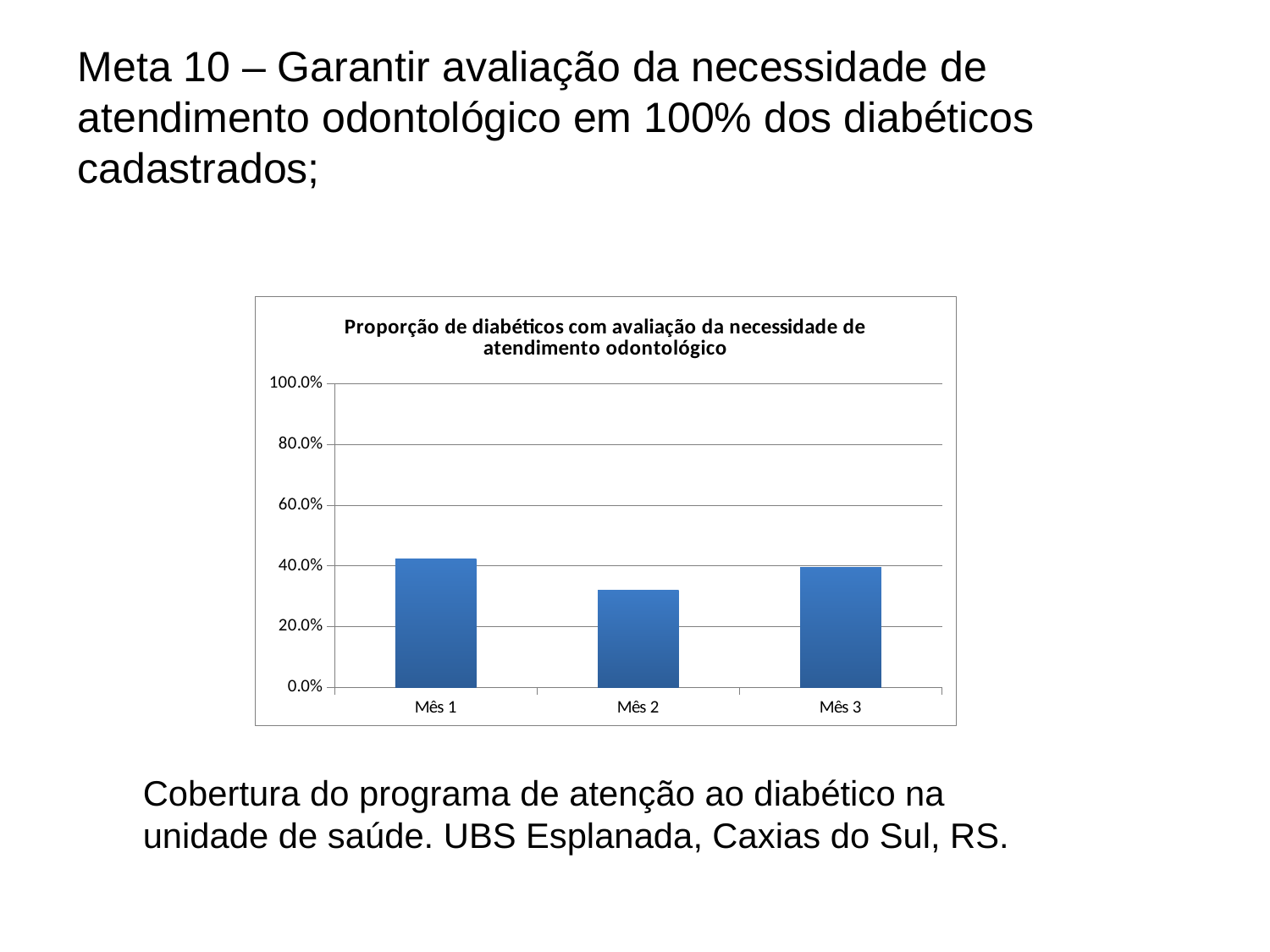
What is the highest value shown on the chart's y axis? 100.0% What kind of chart is shown on the slide? bar chart Does the value rise or fall from Mês 1 to Mês 2? fall Is the value for Mês 2 greater or less than 40.0%? less How many categories (months) are shown on the x axis of the chart? 3 Which is larger, the value for Mês 1 or the value for Mês 2? Mês 1 Is the value for Mês 3 greater or less than 20.0%? greater What is the title of the chart? Proporção de diabéticos com avaliação da necessidade de atendimento odontológico Which month has the lowest value in the chart? Mês 2 Is the value for Mês 1 greater or less than 60.0%? less Which month has the highest value in the chart? Mês 1